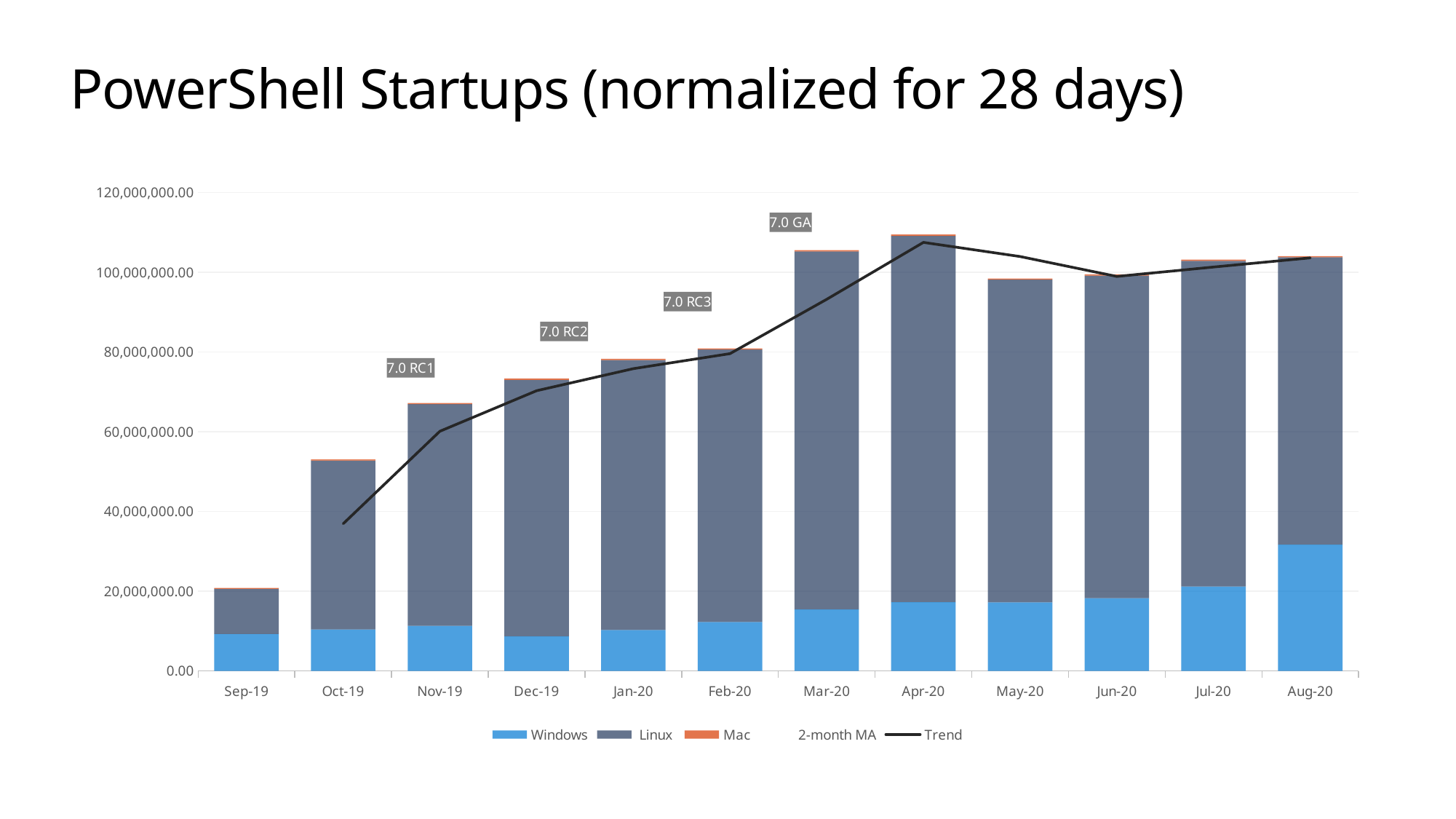
Is the total bar for Sep-19 greater or less than 40,000,000.00? less How many months are shown along the x axis? 12 Is the Windows segment for Aug-20 greater or less than 20,000,000.00? greater Do the total bars rise or fall from Sep-19 to Apr-20? rise Which has the larger total bar, Apr-20 or May-20? Apr-20 Which month has the lowest total bar? Sep-19 What kind of chart is shown on the slide? Stacked bar chart with line series How many entries does the legend list? 5 Which month is annotated with the label "7.0 GA"? Mar-20 Is the total bar for Oct-19 greater or less than 40,000,000.00? greater Which month has the highest total bar? Apr-20